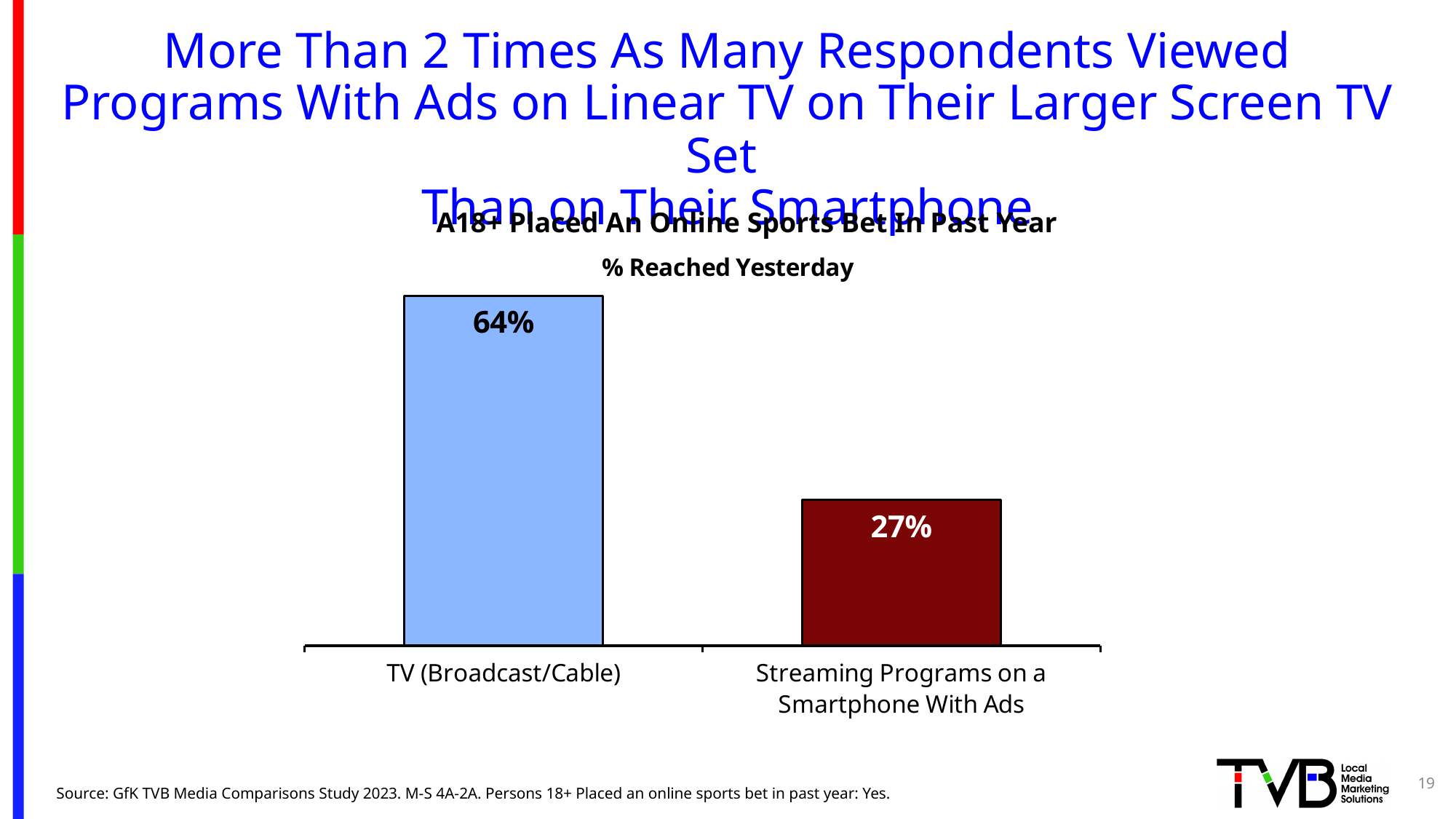
Which category has the lowest value? Streaming Programs on a Smartphone With Ads Which is larger: the value for TV (Broadcast/Cable) or the value for Streaming Programs on a Smartphone With Ads? TV (Broadcast/Cable) What is the value for TV (Broadcast/Cable)? 64% What is the subtitle shown above the bars in the chart? % Reached Yesterday Which category has the highest value? TV (Broadcast/Cable) What kind of chart is shown on the slide? Bar chart How many categories are shown in the chart? 2 What is the value for Streaming Programs on a Smartphone With Ads? 27% What is the difference between the value for TV (Broadcast/Cable) and the value for Streaming Programs on a Smartphone With Ads? 37% What colour is the bar for Streaming Programs on a Smartphone With Ads? Dark red